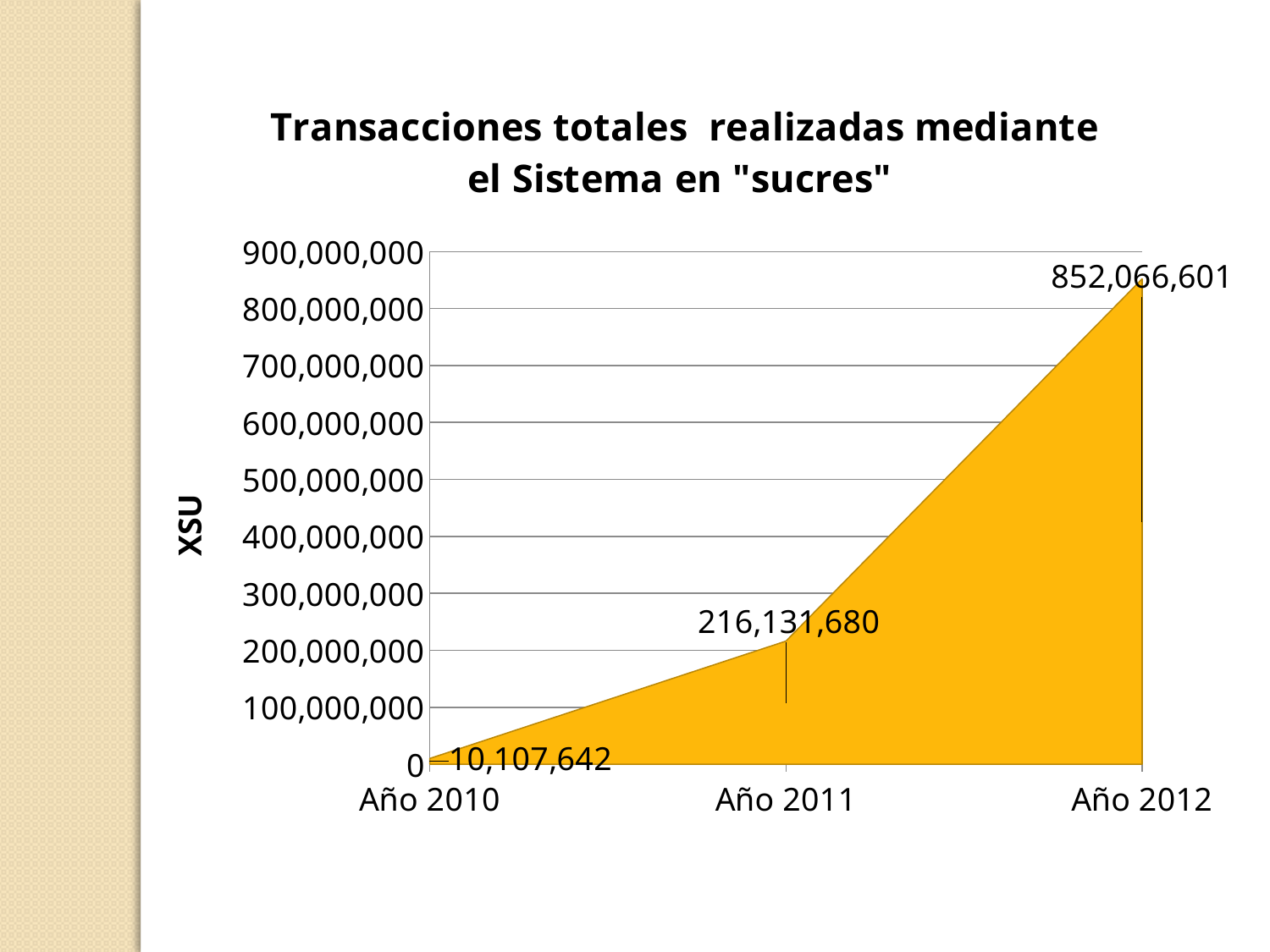
What is the value for Año 2011? 216,131,680 What is the value for Año 2010? 10,107,642 Which year has the lowest value? Año 2010 What kind of chart is shown on the slide? area chart What is the difference between the values for Año 2012 and Año 2011? 635,934,921 What is the value for Año 2012? 852,066,601 Which is larger, the value for Año 2011 or the value for Año 2010? Año 2011 Is the value for Año 2012 greater or less than 800,000,000? greater What is the difference between the values for Año 2011 and Año 2010? 206,024,038 Do the values rise or fall from Año 2010 to Año 2012? rise Which year has the highest value? Año 2012 How many years are plotted on the x axis? 3